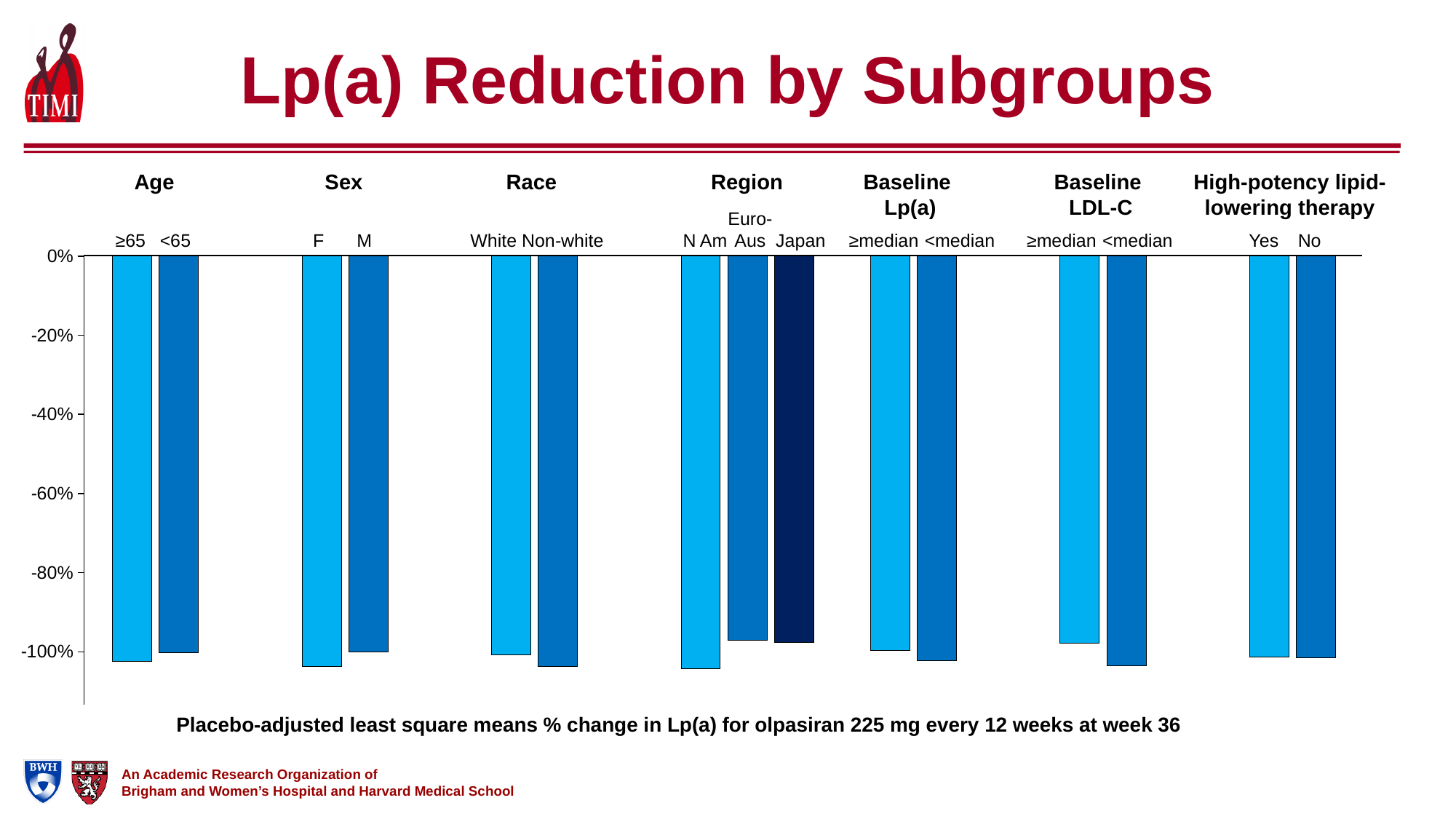
What is the title of the slide's chart? Lp(a) Reduction by Subgroups How many subgroup headings (Age, Sex, Race, etc.) are shown above the chart? 7 Is the value for Non-white greater or less than -80%? less How many categories are plotted under the Region subgroup? 3 What kind of chart is shown on the slide? bar chart Is the value for the Baseline LDL-C ≥median group greater or less than -40%? less Is the value for the ≥65 age group greater or less than -80%? less How many bars are plotted in the chart? 15 What is the lowest value shown on the y axis? -100%